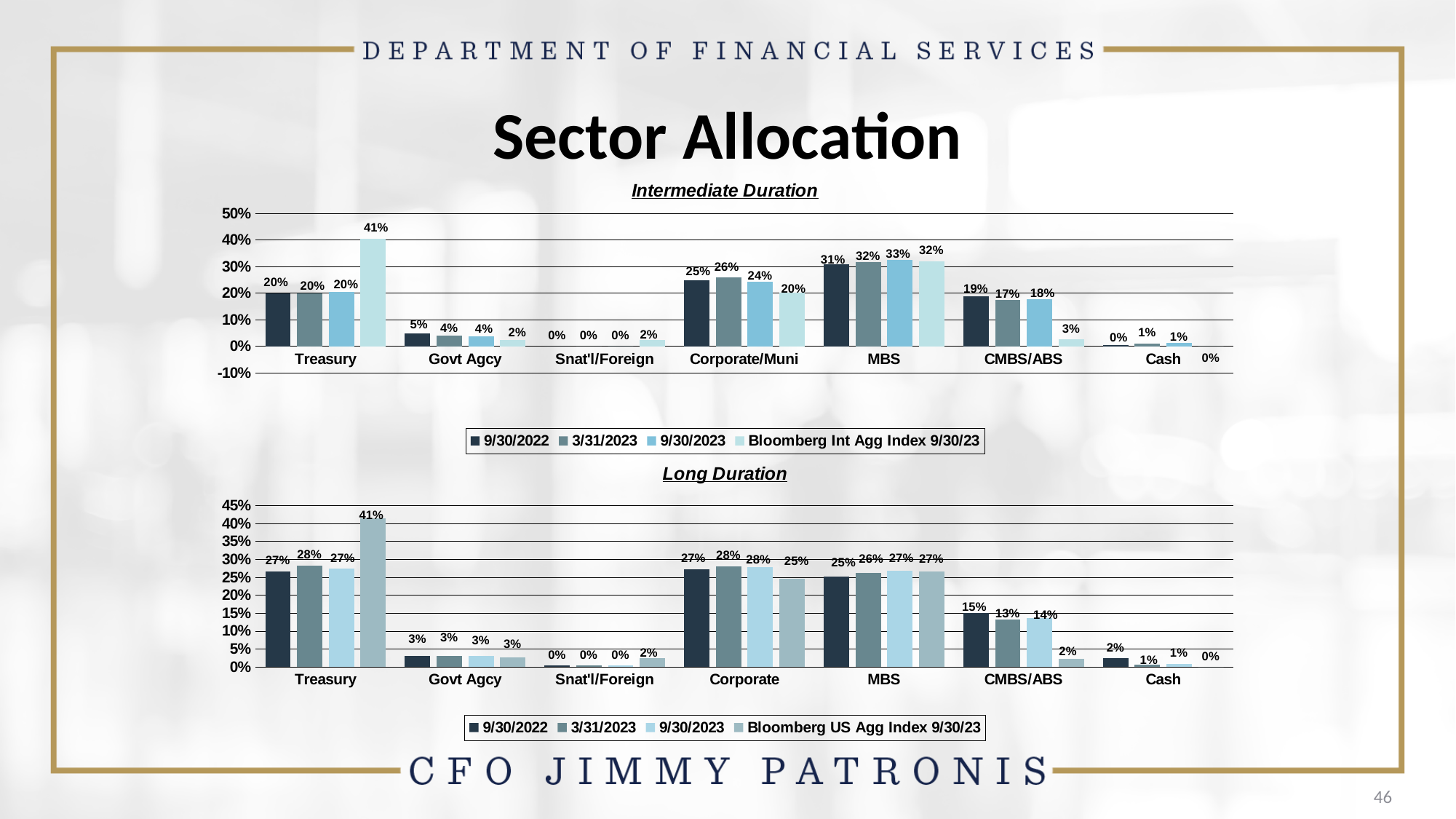
In the Intermediate Duration chart, which category has the highest value for the 9/30/2022 series? MBS In the Intermediate Duration chart, what is the value for MBS on 9/30/2023? 33% In the Long Duration chart, what is the value for CMBS/ABS on 9/30/2022? 15% How many series does the legend of the Intermediate Duration chart list? 4 In the Long Duration chart, which category has the lowest value for the Bloomberg US Agg Index 9/30/23 series? Cash What kind of chart is the Long Duration chart? Bar chart In the Intermediate Duration chart, what is the difference between the Corporate/Muni values for 3/31/2023 and the Bloomberg Int Agg Index 9/30/23? 6% How many categories are shown on the x axis of the Long Duration chart? 7 In the Long Duration chart, what is the difference between the Treasury values for the Bloomberg US Agg Index 9/30/23 and 9/30/2023? 14% In the Intermediate Duration chart, what is the value for Treasury in the Bloomberg Int Agg Index 9/30/23 series? 41% In the Long Duration chart, which is larger for Treasury: the 3/31/2023 value or the 9/30/2023 value? 3/31/2023 What is the name of the fourth legend entry in the Long Duration chart? Bloomberg US Agg Index 9/30/23